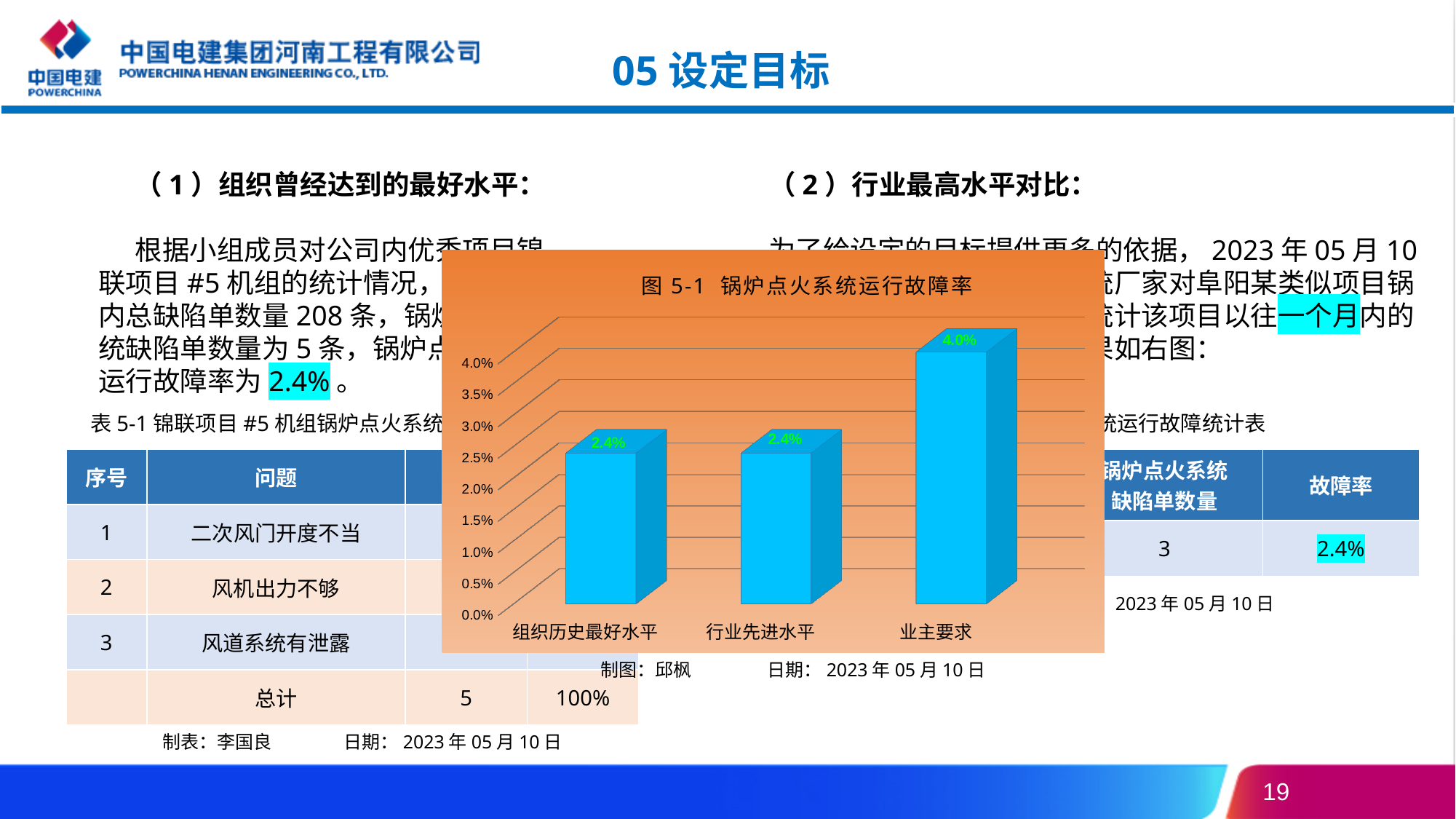
What is the value for 行业先进水平 in the chart? 2.4% Is the value for 组织历史最好水平 greater or less than 3.0%? less What kind of chart is shown on the slide? bar chart Which is larger, the value for 业主要求 or the value for 行业先进水平? 业主要求 How many categories are shown in the chart? 3 Do the values for 组织历史最好水平 and 行业先进水平 differ? No, both are 2.4% What is the value for 组织历史最好水平 in the chart? 2.4% Is the value for 业主要求 greater or less than 3.0%? greater What is the value for 业主要求 in the chart? 4.0% What is the title of the chart? 图 5-1 锅炉点火系统运行故障率 Which category has the highest value in the chart? 业主要求 What is the difference between the values for 业主要求 and 组织历史最好水平? 1.6%